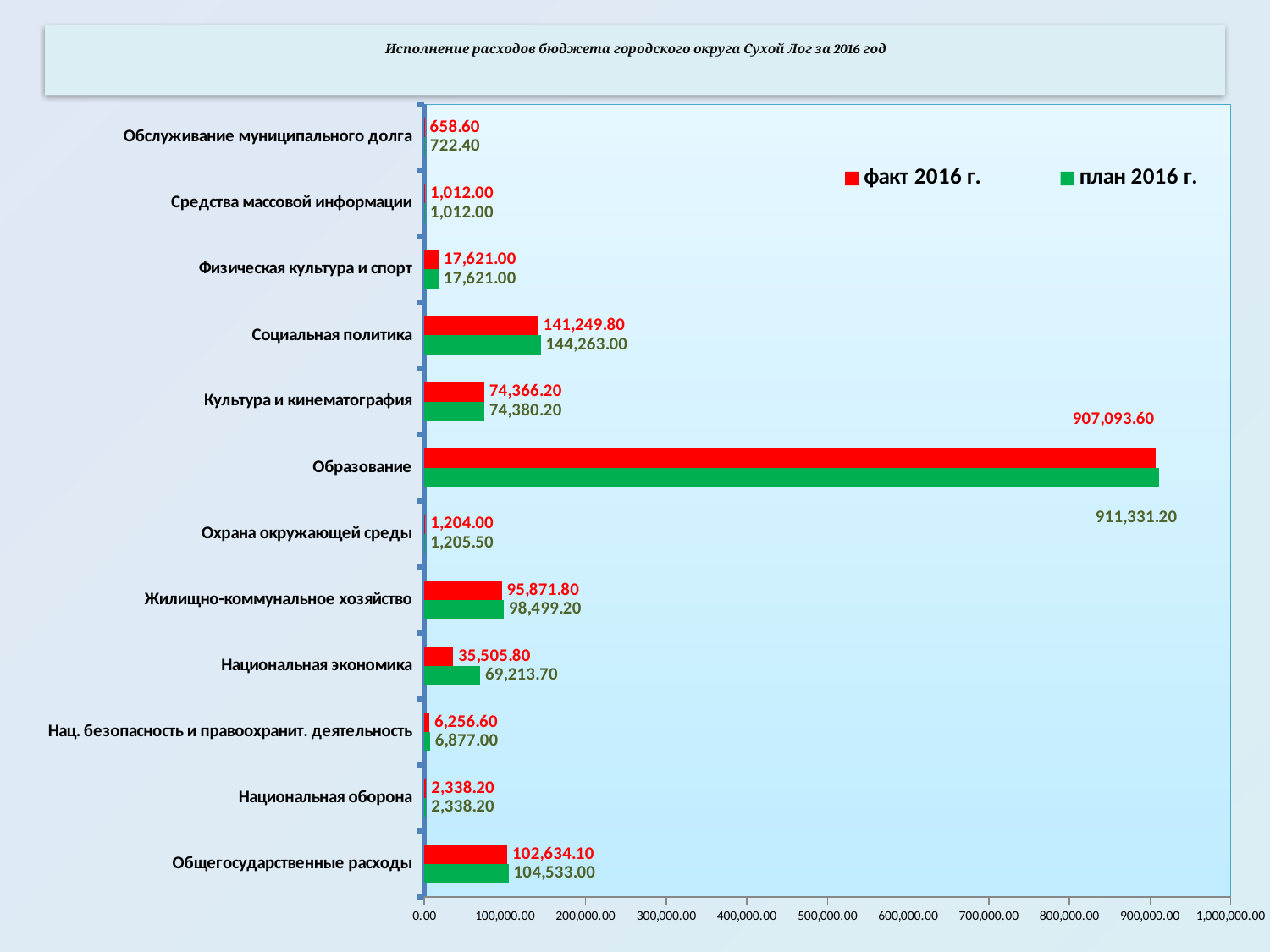
How many series does the legend list? 2 Which category has the highest план 2016 г. value? Образование How many categories are shown on the chart? 12 What type of chart is shown on the slide? bar chart Which series is shown in red? факт 2016 г. Which category has the lowest факт 2016 г. value? Обслуживание муниципального долга What is the value of факт 2016 г. for Образование? 907,093.60 What is the difference between план 2016 г. and факт 2016 г. for Национальная экономика? 33,707.90 What is the value of план 2016 г. for Национальная экономика? 69,213.70 What is the difference between план 2016 г. and факт 2016 г. for Образование? 4,237.60 What is the value of факт 2016 г. for Жилищно-коммунальное хозяйство? 95,871.80 Which is larger: факт 2016 г. for Социальная политика or факт 2016 г. for Общегосударственные расходы? Социальная политика